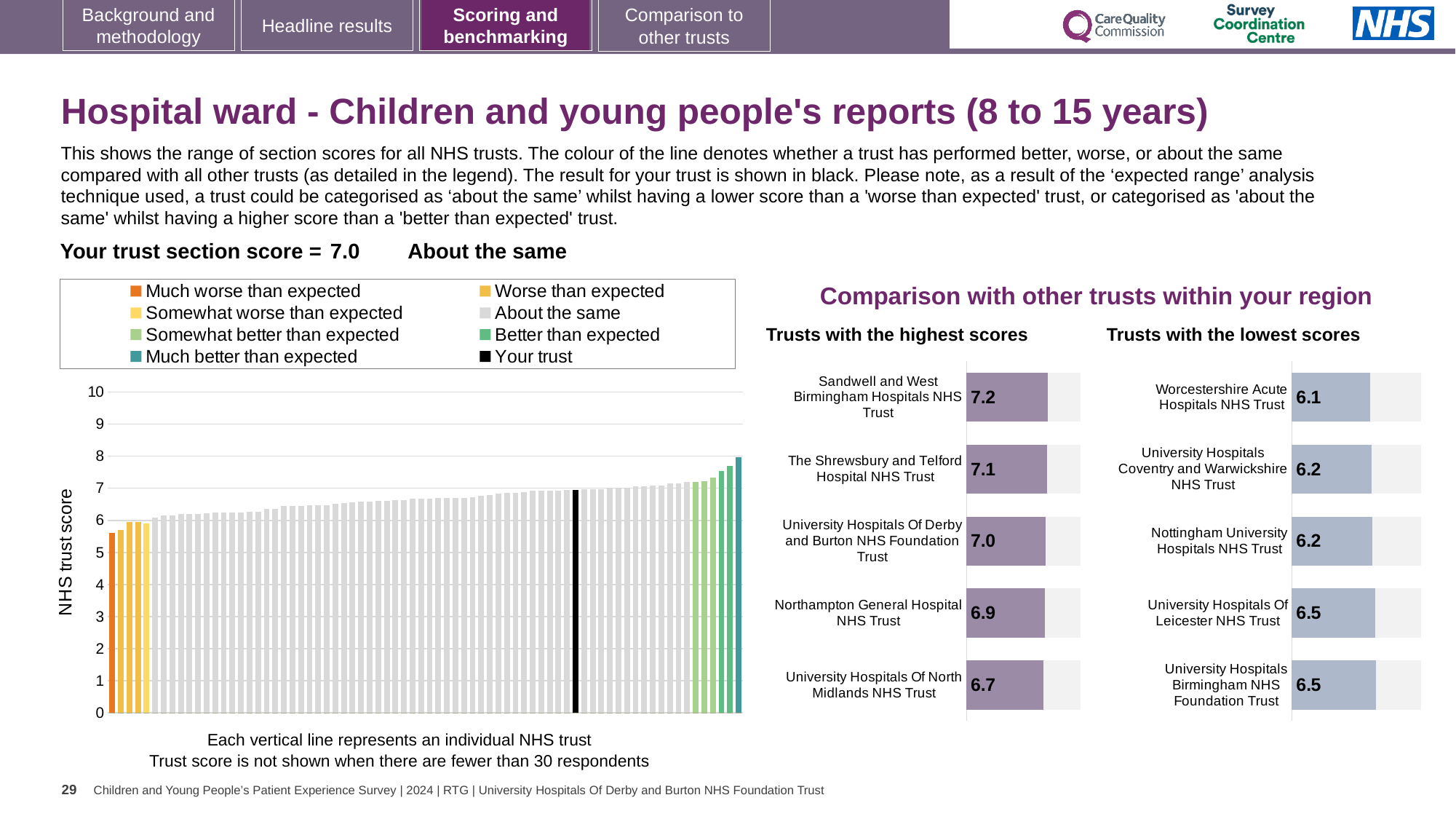
In the 'Trusts with the highest scores' chart, which has the larger score: Northampton General Hospital NHS Trust or The Shrewsbury and Telford Hospital NHS Trust? The Shrewsbury and Telford Hospital NHS Trust In the 'Trusts with the highest scores' chart, what is the score for Sandwell and West Birmingham Hospitals NHS Trust? 7.2 How many entries does the legend above the large chart on the left list? 8 In the 'Trusts with the highest scores' chart, which trust has the highest score? Sandwell and West Birmingham Hospitals NHS Trust In the 'Trusts with the highest scores' chart, what is the difference between the scores of Sandwell and West Birmingham Hospitals NHS Trust and University Hospitals Of North Midlands NHS Trust? 0.5 In the large chart on the left, do the trust scores rise or fall from left to right? Rise What kind of chart is the large chart on the left showing NHS trust scores? Bar chart In the 'Trusts with the lowest scores' chart, what is the score for Worcestershire Acute Hospitals NHS Trust? 6.1 How many trusts are shown in the 'Trusts with the lowest scores' chart? 5 In the large chart on the left, what is the score of the trust shown in black (your trust)? 7.0 In the 'Trusts with the lowest scores' chart, which trust has the lowest score? Worcestershire Acute Hospitals NHS Trust In the 'Trusts with the lowest scores' chart, what is the difference between the scores of University Hospitals Of Leicester NHS Trust and Worcestershire Acute Hospitals NHS Trust? 0.4